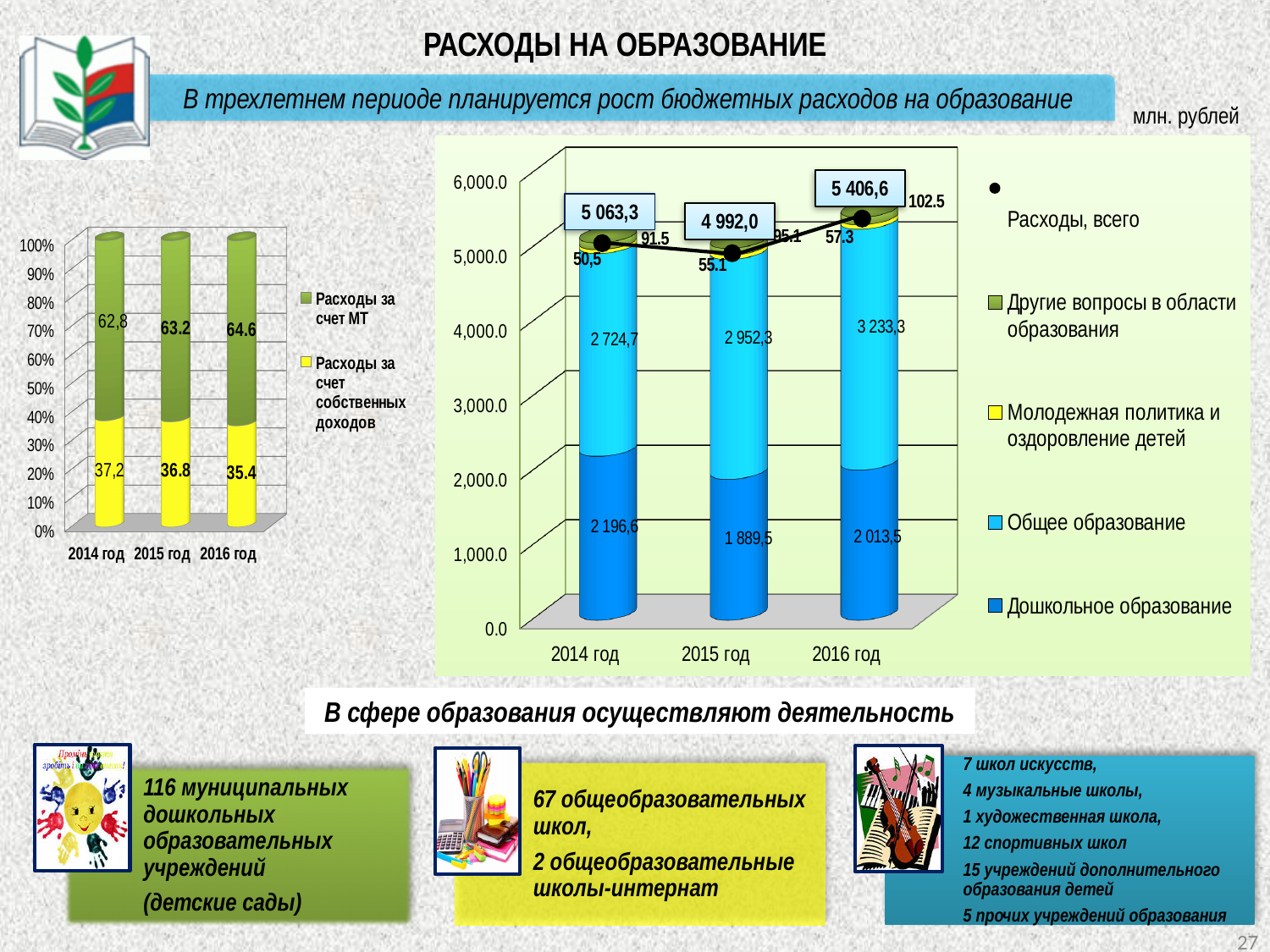
In the right chart, how many series does the legend list? 5 In the right chart, what is the value for 'Общее образование' in 2015 год? 2 952,3 In the right chart, which year has the highest value for 'Общее образование'? 2016 год In the right chart, is the value for 'Дошкольное образование' in 2015 год greater or less than 2,000.0? less What kind of chart is the left chart? bar chart In the left chart, how many years are shown on the x axis? 3 In the right chart, what is the value of 'Расходы, всего' for 2016 год? 5 406,6 In the right chart, which year has the lowest value of 'Расходы, всего'? 2015 год In the left chart, what is the value for 'Расходы за счет МТ' in 2016 год? 64.6 In the right chart, what is the value for 'Дошкольное образование' in 2014 год? 2 196,6 In the left chart, does the share of 'Расходы за счет собственных доходов' rise or fall from 2014 год to 2016 год? fall In the left chart, what is the value for 'Расходы за счет собственных доходов' in 2014 год? 37,2